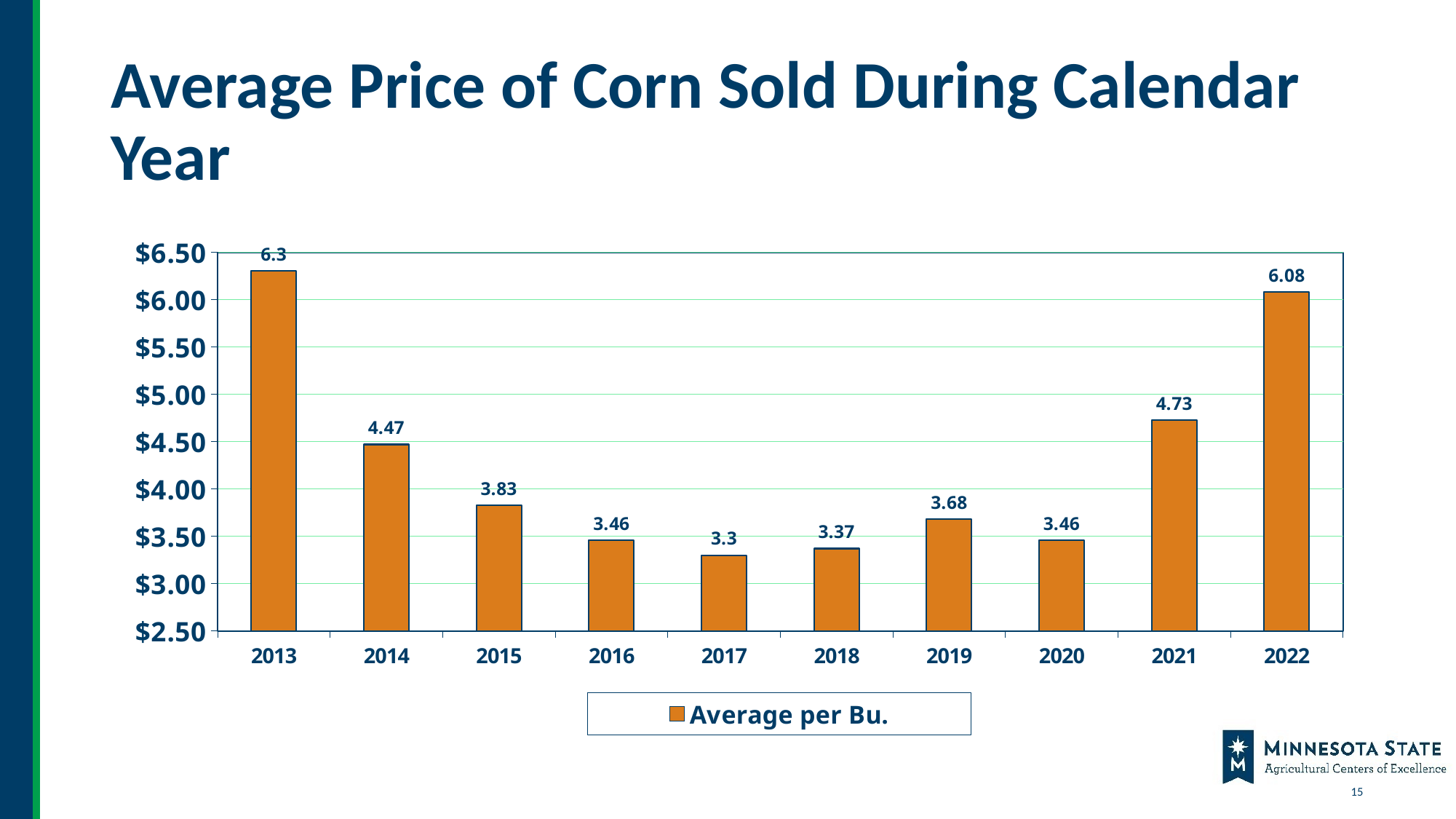
How many series does the legend list? 1 What is the average price of corn per bushel for 2021? 4.73 Is the value for 2019 greater or less than $4.00? less Which year has the highest average price of corn? 2013 What kind of chart is shown on the slide? bar chart What is the average price of corn per bushel for 2017? 3.3 What is the difference between the average price in 2022 and in 2021? 1.35 Which year has a higher average price of corn, 2014 or 2015? 2014 How many years are shown on the x axis of the chart? 10 What is the legend entry for the series in the chart? Average per Bu. What is the average price of corn per bushel for 2013? 6.3 Which year has the lowest average price of corn? 2017